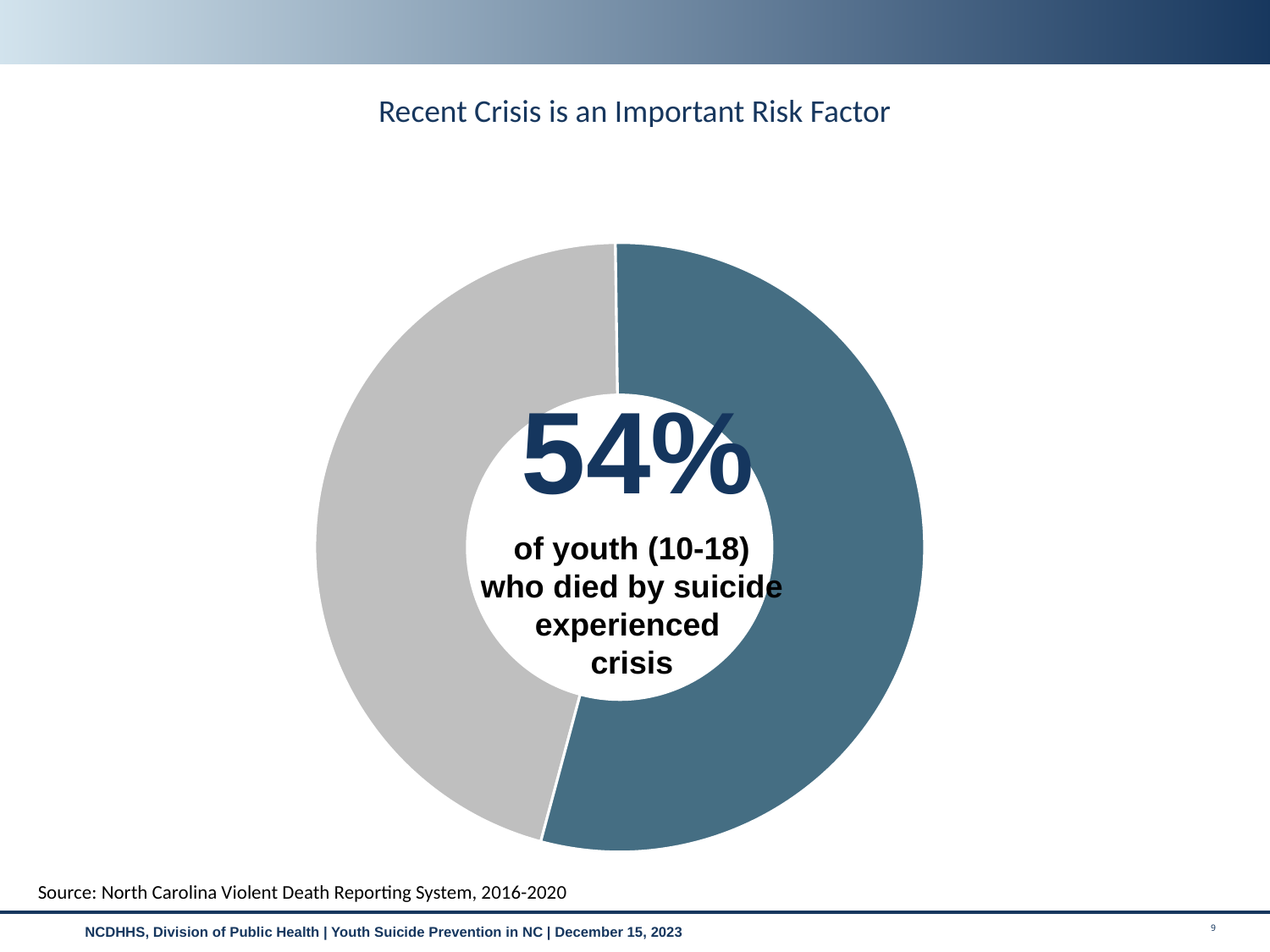
What share of the donut does the gray slice represent, given the blue slice is 54%? 46% What data source is cited for the chart? North Carolina Violent Death Reporting System, 2016-2020 Is the share represented by the gray slice greater or less than 50%? less What kind of chart is shown on the slide? Donut chart How many slices does the donut chart have? 2 Which slice of the donut chart is larger, the blue slice or the gray slice? The blue slice What percentage of youth (10-18) who died by suicide experienced crisis, according to the chart? 54% Is the share represented by the blue slice greater or less than 50%? greater What is the title of the slide containing the chart? Recent Crisis is an Important Risk Factor